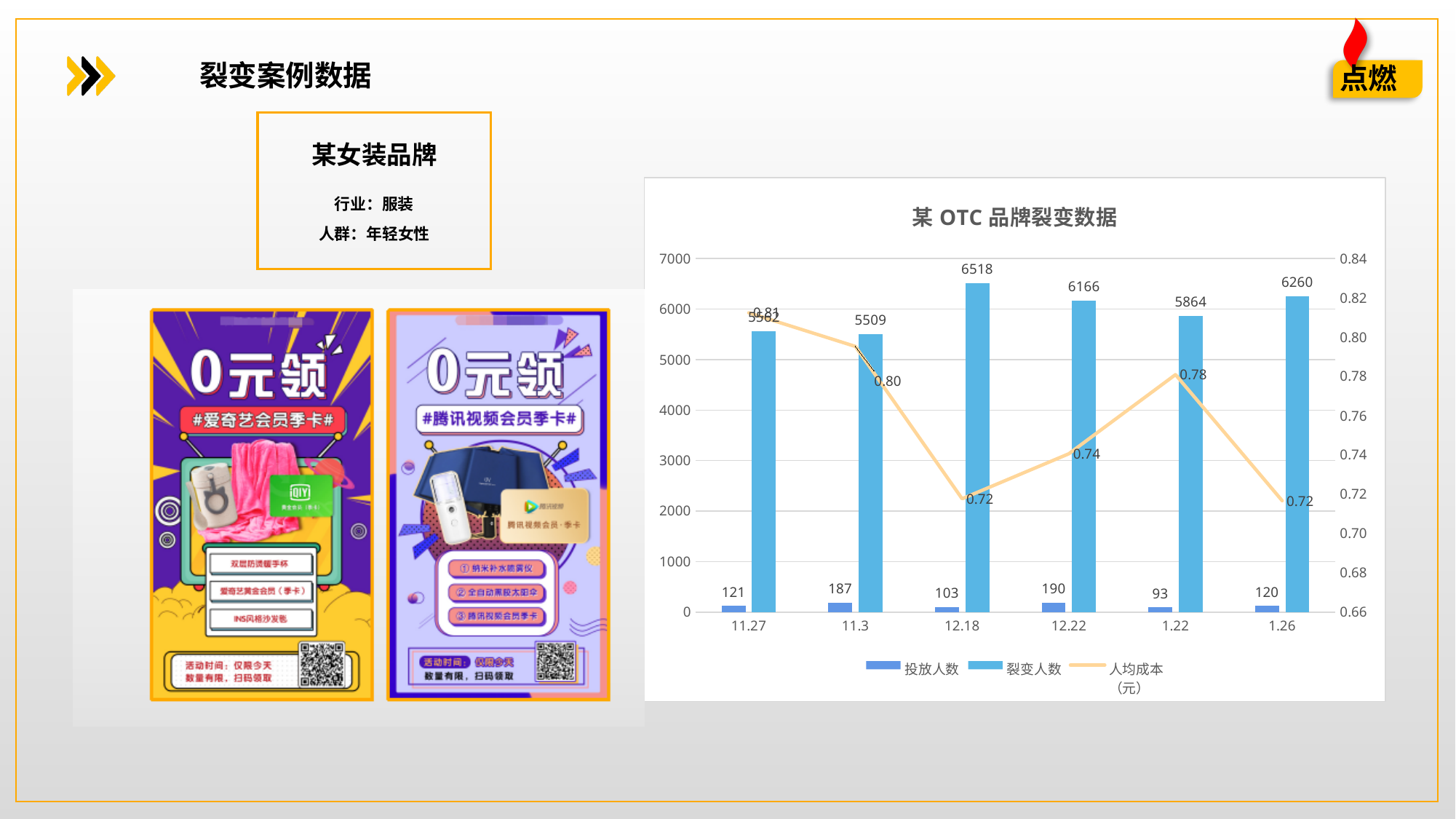
Which date has the lowest 投放人数? 1.22 Which is larger, the 投放人数 on 11.3 or on 12.22? 12.22 What is the difference in 裂变人数 between 12.18 and 12.22? 352 What is the value of 投放人数 on 1.22? 93 How many series does the legend list? 3 How many dates are shown on the x axis? 6 What is the value of 裂变人数 on 12.18? 6518 What is the 人均成本（元） value on 11.27? 0.81 Which date has the highest 裂变人数? 12.18 What is the title of the chart? 某 OTC 品牌裂变数据 Is the 裂变人数 on 1.26 greater or less than 6000? greater What kind of chart is used for 裂变人数? bar chart